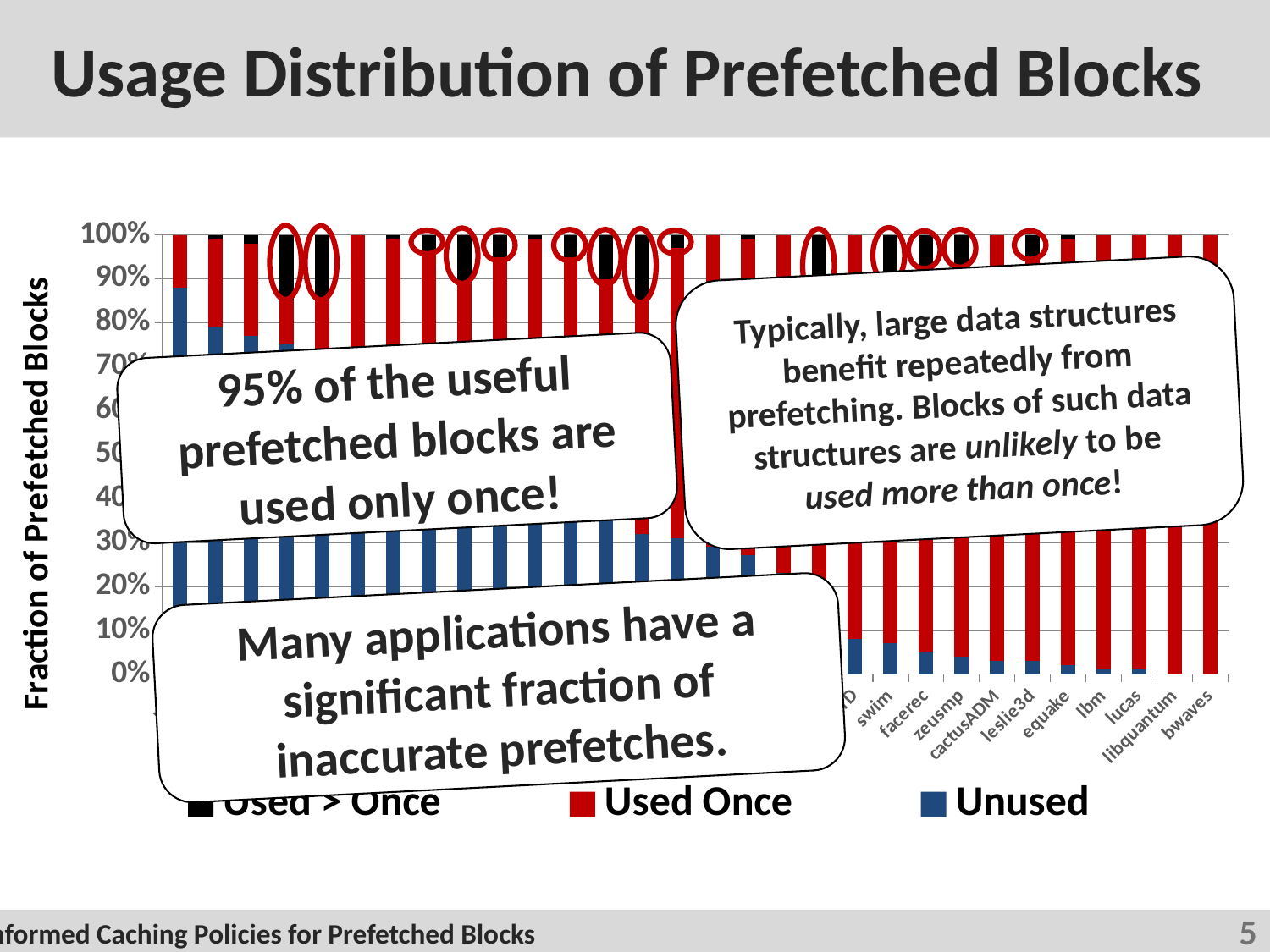
Which has the larger Unused fraction, swim or bwaves? swim How many series does the chart's legend list? 3 What is the label of the chart's vertical axis? Fraction of Prefetched Blocks What kind of chart is shown on the slide? Stacked bar chart Is the Used Once fraction for lucas greater or less than 90%? greater Is the Unused fraction for bwaves greater or less than 10%? less What are the three series listed in the chart's legend? Used > Once, Used Once, Unused Which has the larger Used Once fraction, bwaves or swim? bwaves Is the Used Once fraction for bwaves greater or less than 90%? greater Does the Unused fraction rise or fall moving from left to right along the x axis? fall